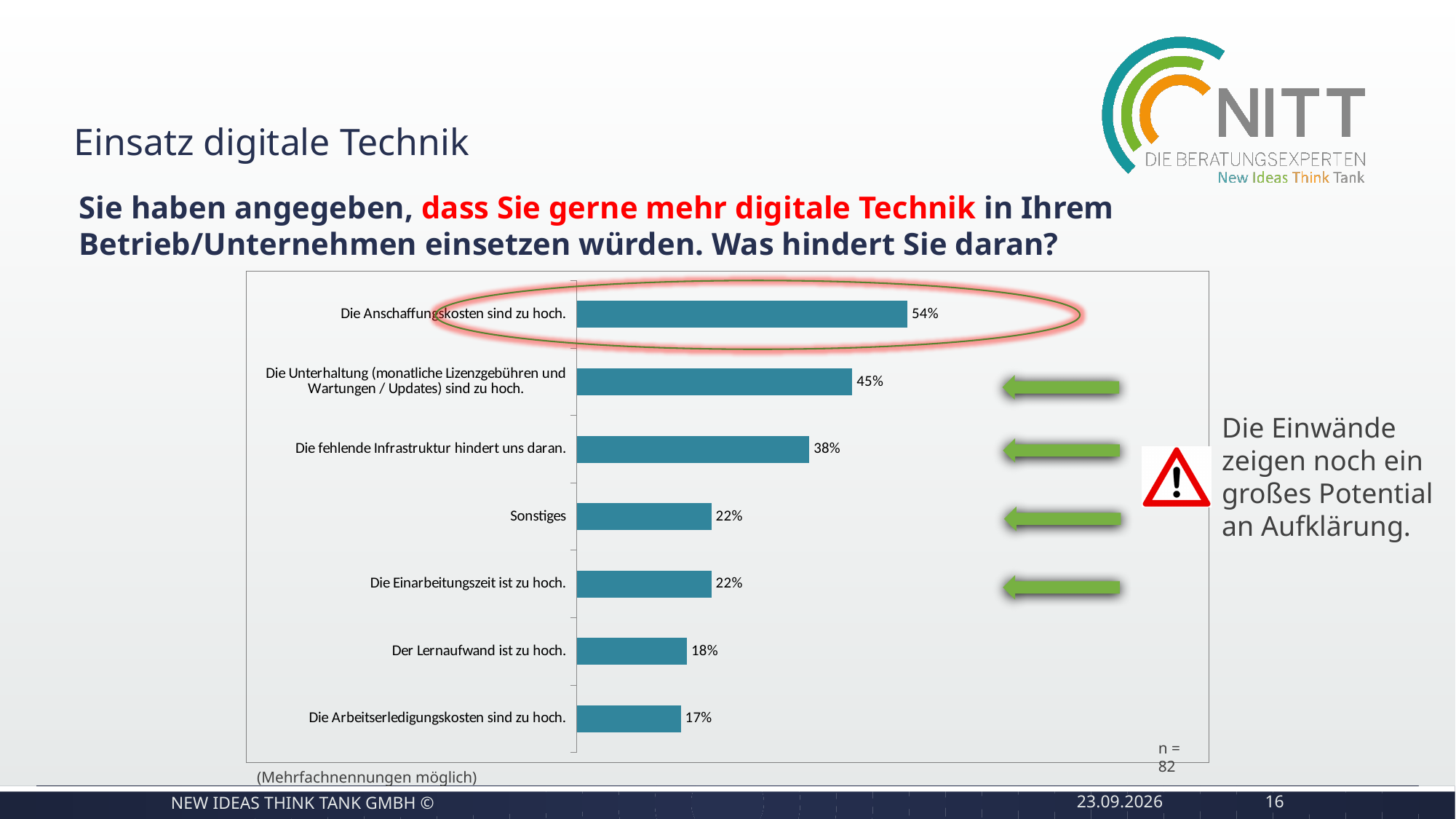
What value is shown for "Die fehlende Infrastruktur hindert uns daran."? 38% How many categories are shown in the chart? 7 What is the difference between the values for "Die Anschaffungskosten sind zu hoch." and "Die fehlende Infrastruktur hindert uns daran."? 16% Which category has the lowest value in the chart? Die Arbeitserledigungskosten sind zu hoch. Which is larger: the value for "Sonstiges" or the value for "Der Lernaufwand ist zu hoch."? Sonstiges What is the difference between the values for "Der Lernaufwand ist zu hoch." and "Die Arbeitserledigungskosten sind zu hoch."? 1% What percentage is shown for "Der Lernaufwand ist zu hoch."? 18% What percentage is shown for "Die Anschaffungskosten sind zu hoch."? 54% What value is shown for "Die Unterhaltung (monatliche Lizenzgebühren und Wartungen / Updates) sind zu hoch."? 45% What sample size (n) is noted on the chart? n = 82 Which category has the highest value in the chart? Die Anschaffungskosten sind zu hoch. What kind of chart is shown on the slide? Bar chart